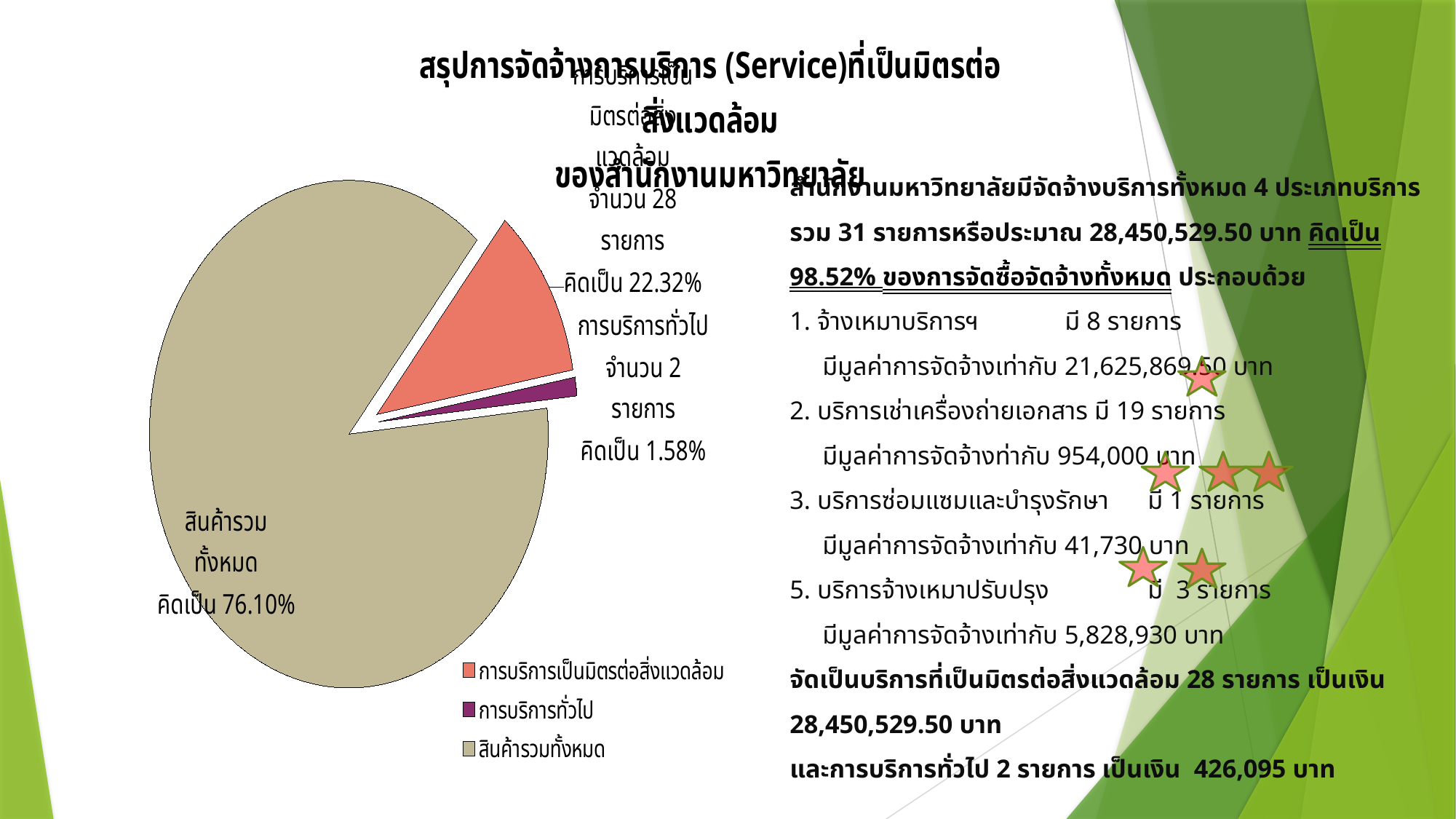
How many items (รายการ) are labelled for the การบริการเป็นมิตรต่อสิ่งแวดล้อม slice? 28 How many items (รายการ) are labelled for the การบริการทั่วไป slice? 2 What is the difference in percentage points between the สินค้ารวมทั้งหมด slice and the การบริการเป็นมิตรต่อสิ่งแวดล้อม slice? 53.78 What percentage share does the การบริการเป็นมิตรต่อสิ่งแวดล้อม slice represent? 22.32% Which slice of the pie chart is the smallest? การบริการทั่วไป How many slices does the pie chart have? 3 What percentage share does the การบริการทั่วไป slice represent? 1.58% What percentage share does the สินค้ารวมทั้งหมด slice represent? 76.10% How many entries does the pie chart's legend list? 3 What kind of chart is shown on the slide? pie chart Which colour is used for the การบริการทั่วไป slice in the pie chart? purple Which slice of the pie chart is the largest? สินค้ารวมทั้งหมด